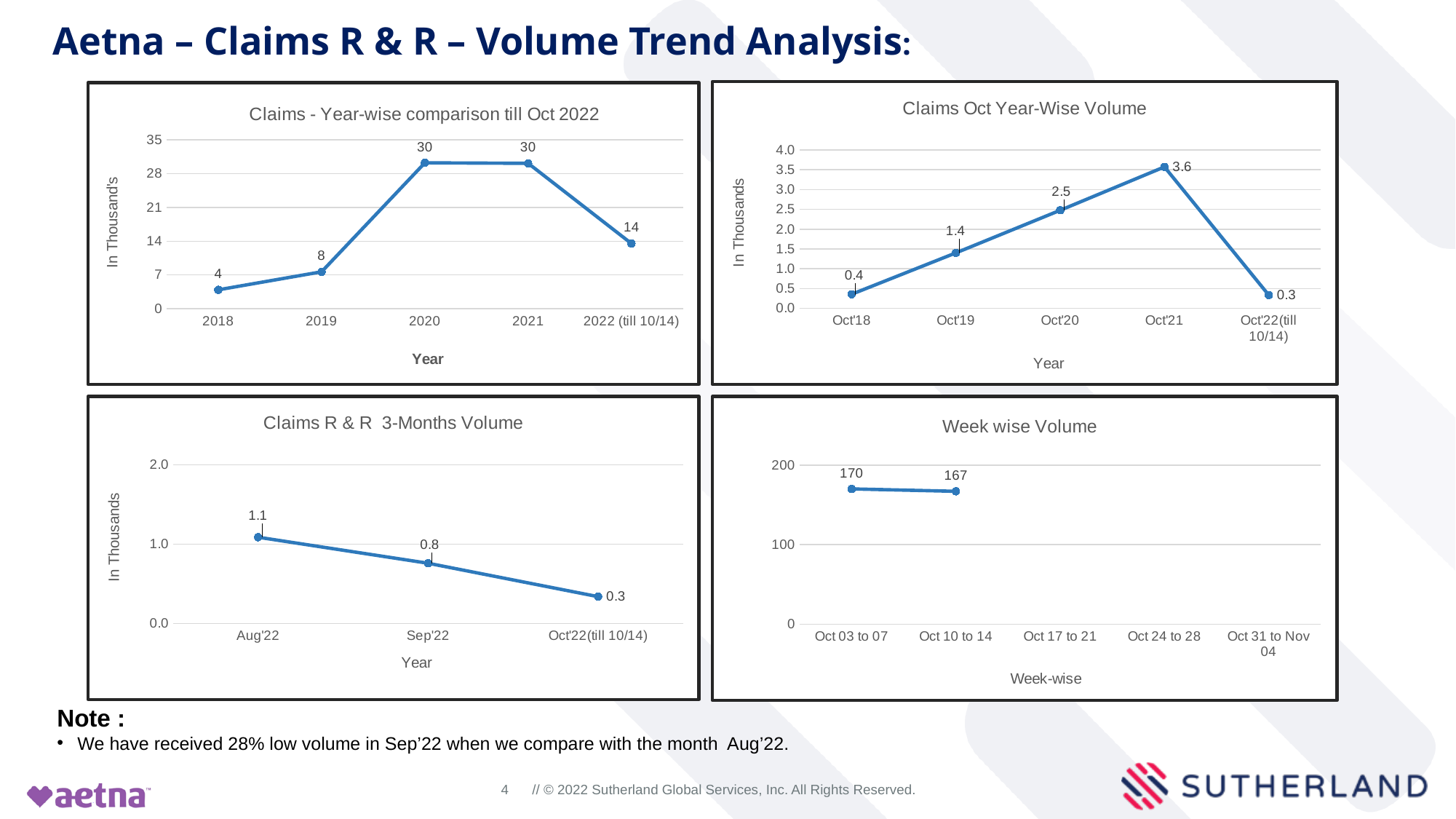
In the 'Claims R & R 3-Months Volume' chart, what is the value for Sep'22? 0.8 In the 'Claims - Year-wise comparison till Oct 2022' chart, what is the value for 2022 (till 10/14)? 14 In the 'Week wise Volume' chart, what is the difference between the values for Oct 03 to 07 and Oct 10 to 14? 3 In the 'Week wise Volume' chart, what is the value for Oct 10 to 14? 167 In the 'Claims - Year-wise comparison till Oct 2022' chart, what is the difference between the values for 2020 and 2018? 26 In the 'Claims - Year-wise comparison till Oct 2022' chart, which year has the lowest value? 2018 In the 'Claims Oct Year-Wise Volume' chart, which category has the highest value? Oct'21 In the 'Claims Oct Year-Wise Volume' chart, what is the value for Oct'20? 2.5 In the 'Claims - Year-wise comparison till Oct 2022' chart, what is the value for 2019? 8 In the 'Claims Oct Year-Wise Volume' chart, which is larger, the value for Oct'19 or Oct'22(till 10/14)? Oct'19 In the 'Claims R & R 3-Months Volume' chart, do the values rise or fall from Aug'22 to Oct'22(till 10/14)? fall What type of chart is the 'Claims Oct Year-Wise Volume' chart? line chart